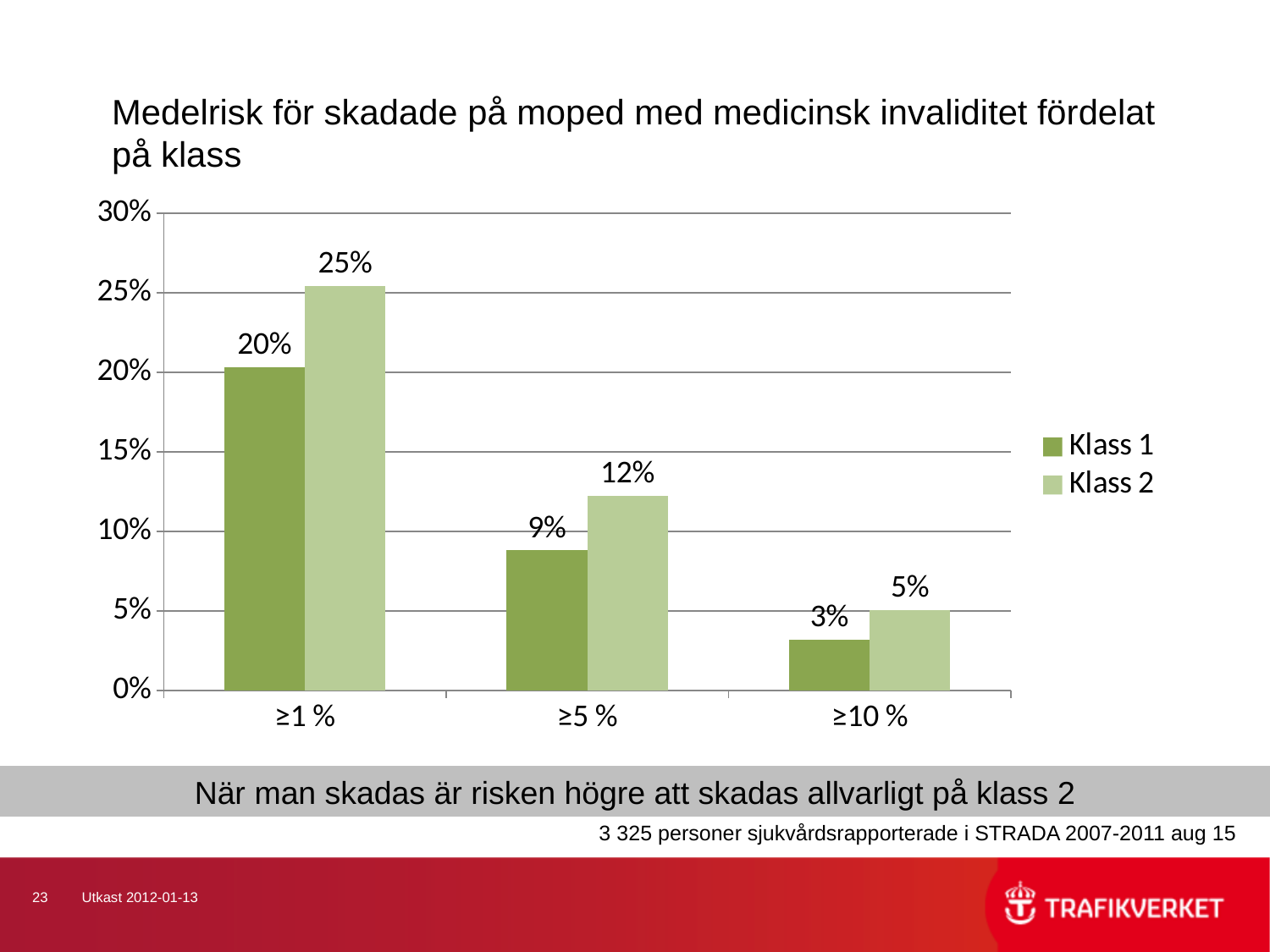
What kind of chart is shown on the slide? bar chart What is the value for Klass 2 in the ≥5 % category? 12% Do the values for Klass 1 rise or fall from ≥1 % to ≥10 %? fall Which is larger in the ≥5 % category, Klass 1 or Klass 2? Klass 2 Which category has the highest value for Klass 2? ≥1 % Which category has the lowest value for Klass 1? ≥10 % Is the value for Klass 2 in the ≥10 % category greater or less than 10%? less How many categories are shown on the x axis? 3 What is the value for Klass 1 in the ≥1 % category? 20% How many series does the legend list? 2 What is the value for Klass 1 in the ≥10 % category? 3% What is the difference between Klass 2 and Klass 1 in the ≥1 % category? 5%